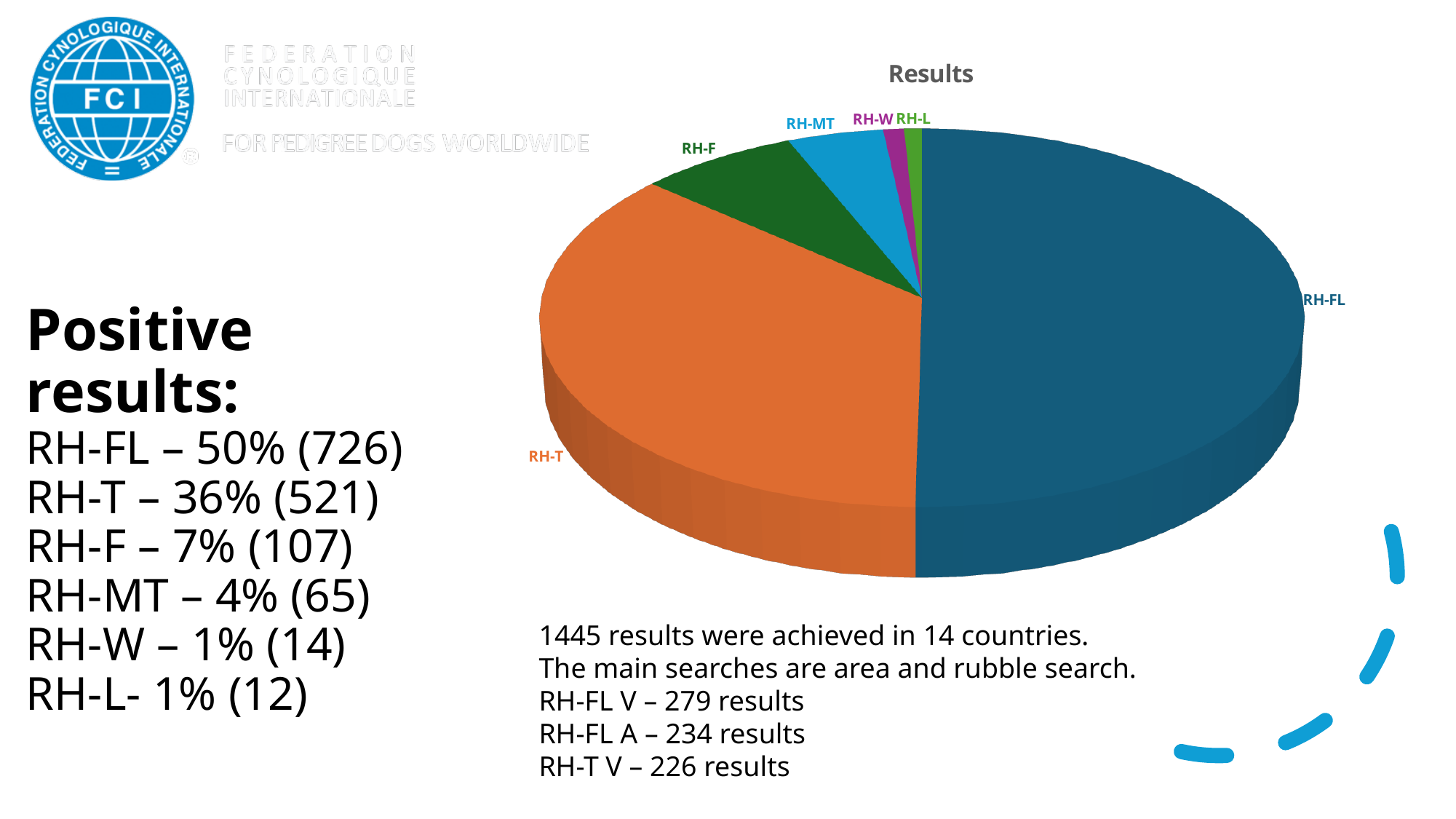
What share of the pie does RH-FL represent? 50% What is the difference in results between RH-FL and RH-T? 205 Which slice is larger, RH-T or RH-F? RH-T What share of the pie does RH-T represent? 36% What kind of chart is shown on the slide? pie chart How many slices does the pie chart have? 6 What is the title of the chart? Results How many results does the RH-MT slice represent? 65 Which category has the largest slice of the pie? RH-FL How many results does the RH-F slice represent? 107 What colour is the RH-T slice? orange Which slice is larger, RH-F or RH-MT? RH-F